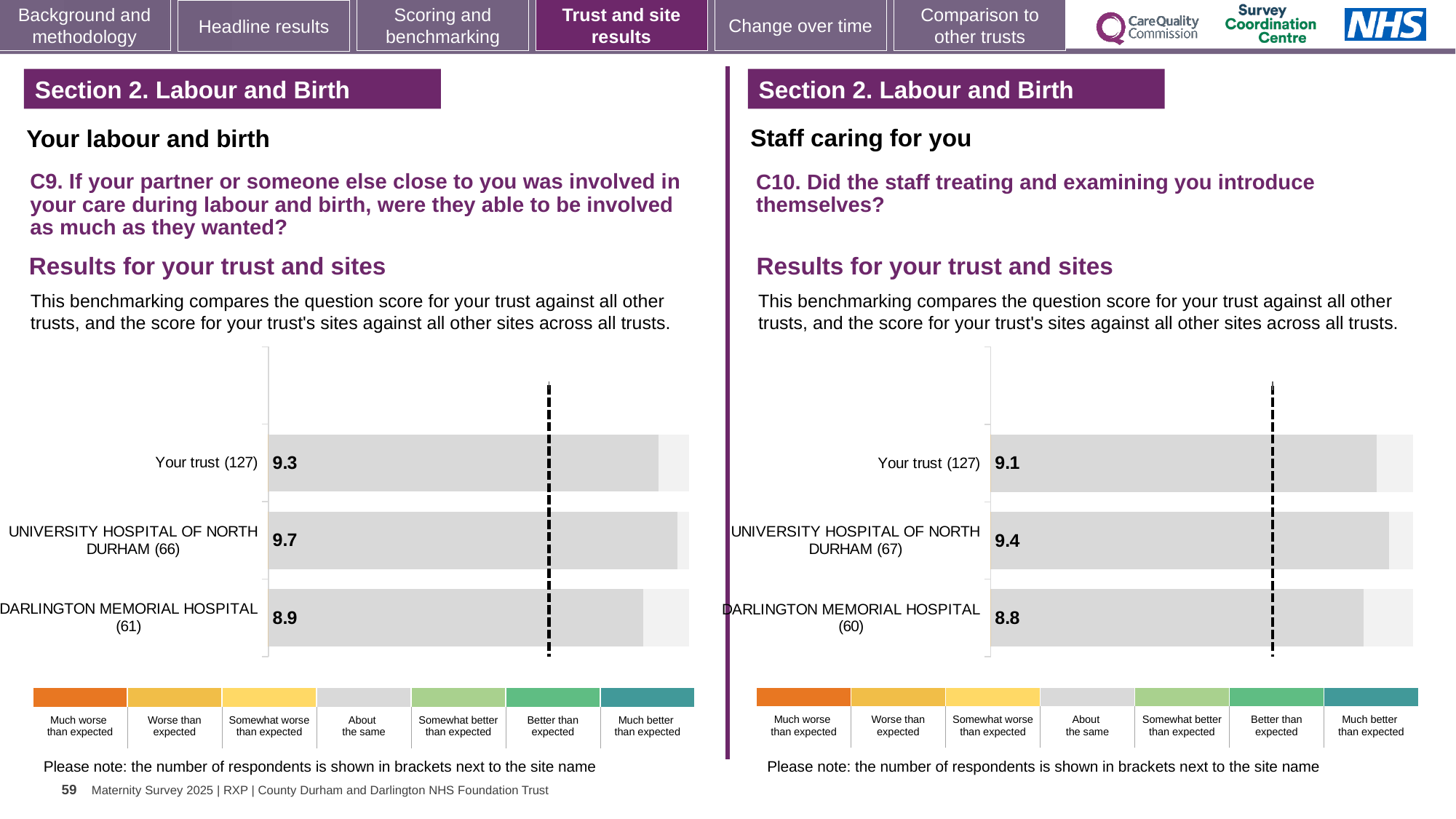
In the right chart (C10), what is the score for DARLINGTON MEMORIAL HOSPITAL (60)? 8.8 In the left chart (C9), which site or trust has the highest score? UNIVERSITY HOSPITAL OF NORTH DURHAM (66) How many bars are shown in the left chart (C9)? 3 In the left chart (C9), what is the score for DARLINGTON MEMORIAL HOSPITAL (61)? 8.9 In the right chart (C10), what is the score for Your trust (127)? 9.1 In the right chart (C10), what is the difference between the scores for UNIVERSITY HOSPITAL OF NORTH DURHAM (67) and Your trust (127)? 0.3 In the left chart (C9), what is the difference between the scores for UNIVERSITY HOSPITAL OF NORTH DURHAM (66) and DARLINGTON MEMORIAL HOSPITAL (61)? 0.8 In the left chart (C9), what is the score for Your trust (127)? 9.3 In the right chart (C10), which site or trust has the lowest score? DARLINGTON MEMORIAL HOSPITAL (60) In the right chart (C10), which has the larger score: Your trust (127) or DARLINGTON MEMORIAL HOSPITAL (60)? Your trust (127) In the left chart (C9), what is the score for UNIVERSITY HOSPITAL OF NORTH DURHAM (66)? 9.7 What type of chart is used in the right chart (C10)? Bar chart